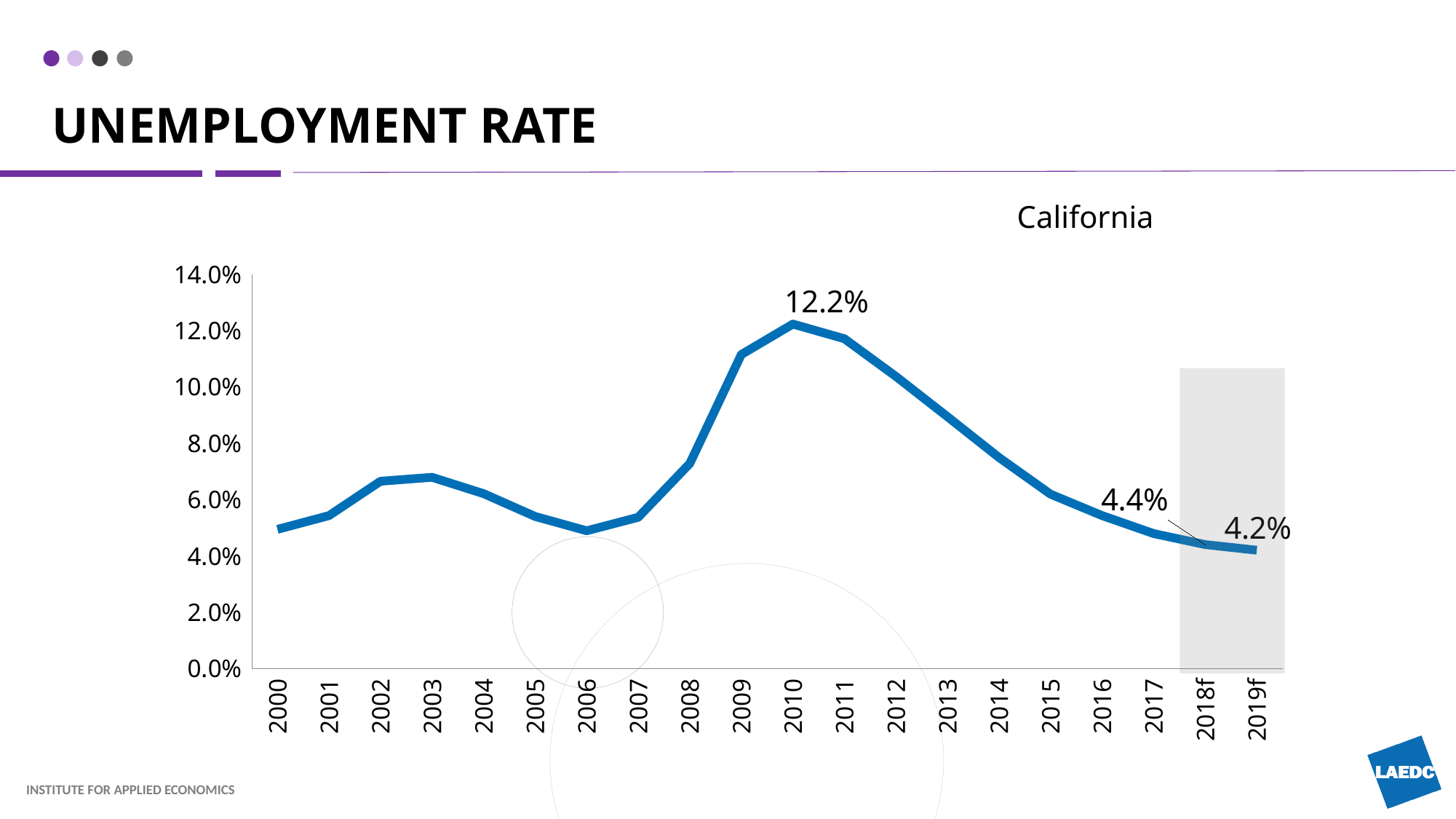
In which year does the unemployment rate reach its highest point? 2010 What is the unemployment rate shown for 2010? 12.2% Is the unemployment rate for 2006 greater or less than 6.0%? less Which year has the higher unemployment rate, 2003 or 2015? 2003 How many years are shown on the x axis? 20 What type of chart is shown on the slide? Line chart Is the unemployment rate for 2009 greater or less than 10.0%? greater Does the unemployment rate rise or fall from 2010 to 2017? Fall What is the difference between the unemployment rate in 2010 and the rate in 2019f? 8.0% What is the difference between the unemployment rate in 2018f and 2019f? 0.2% What is the unemployment rate shown for 2018f? 4.4% What is the unemployment rate shown for 2019f? 4.2%